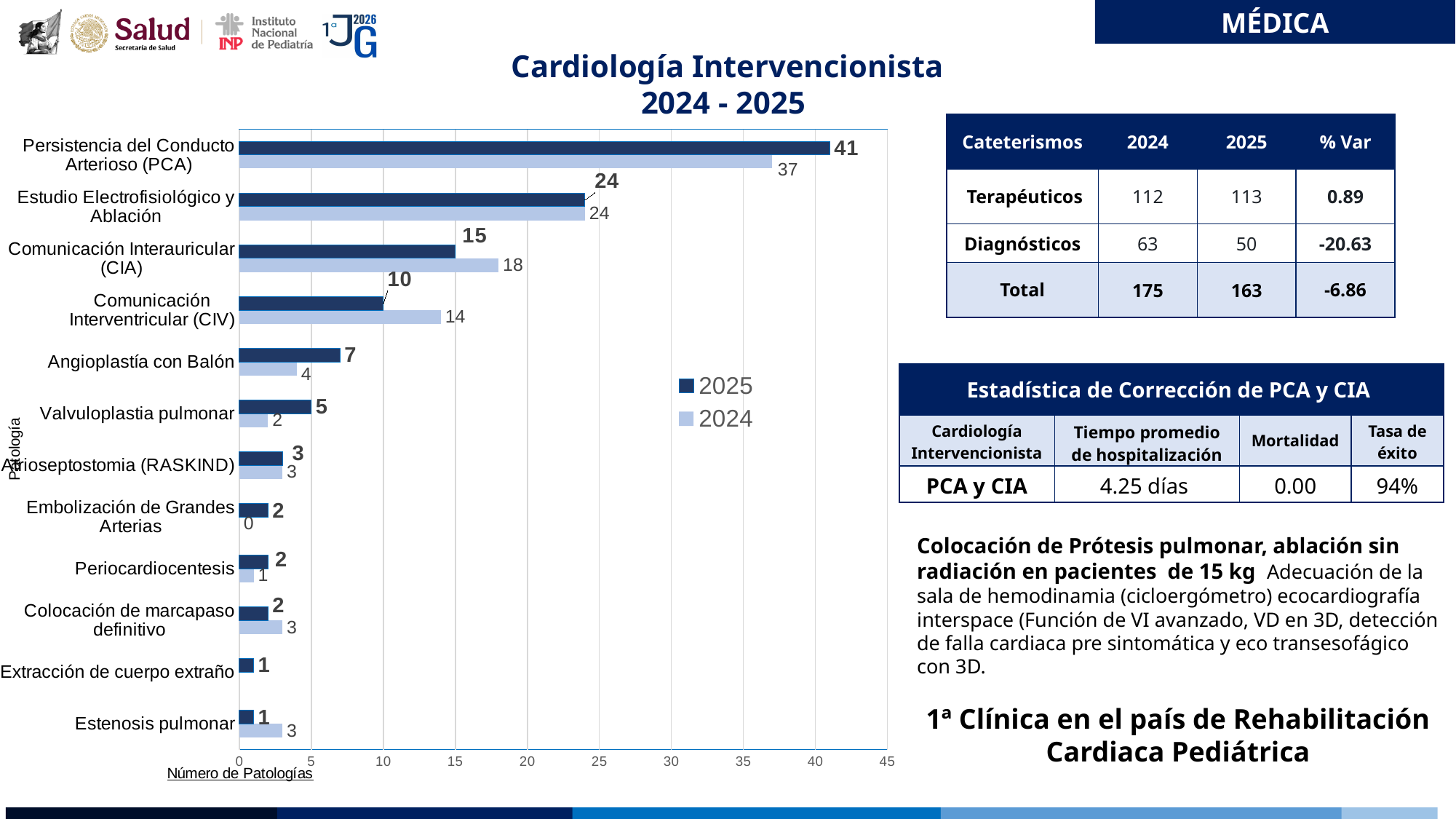
Which is larger for Angioplastía con Balón, the 2025 value or the 2024 value? 2025 How many series does the chart legend list? 2 What is the 2024 value for Comunicación Interventricular (CIV)? 14 Which pathology has the highest 2025 value? Persistencia del Conducto Arterioso (PCA) What is the difference between the 2025 and 2024 values for Persistencia del Conducto Arterioso (PCA)? 4 What is the 2025 value for Persistencia del Conducto Arterioso (PCA)? 41 What is the label of the horizontal axis of the chart? Número de Patologías How many pathology categories are shown in the chart? 12 What is the 2024 value for Embolización de Grandes Arterias? 0 What is the 2024 value for Comunicación Interauricular (CIA)? 18 Is the 2025 value for Estudio Electrofisiológico y Ablación greater or less than 20? greater What type of chart is shown on the slide? bar chart